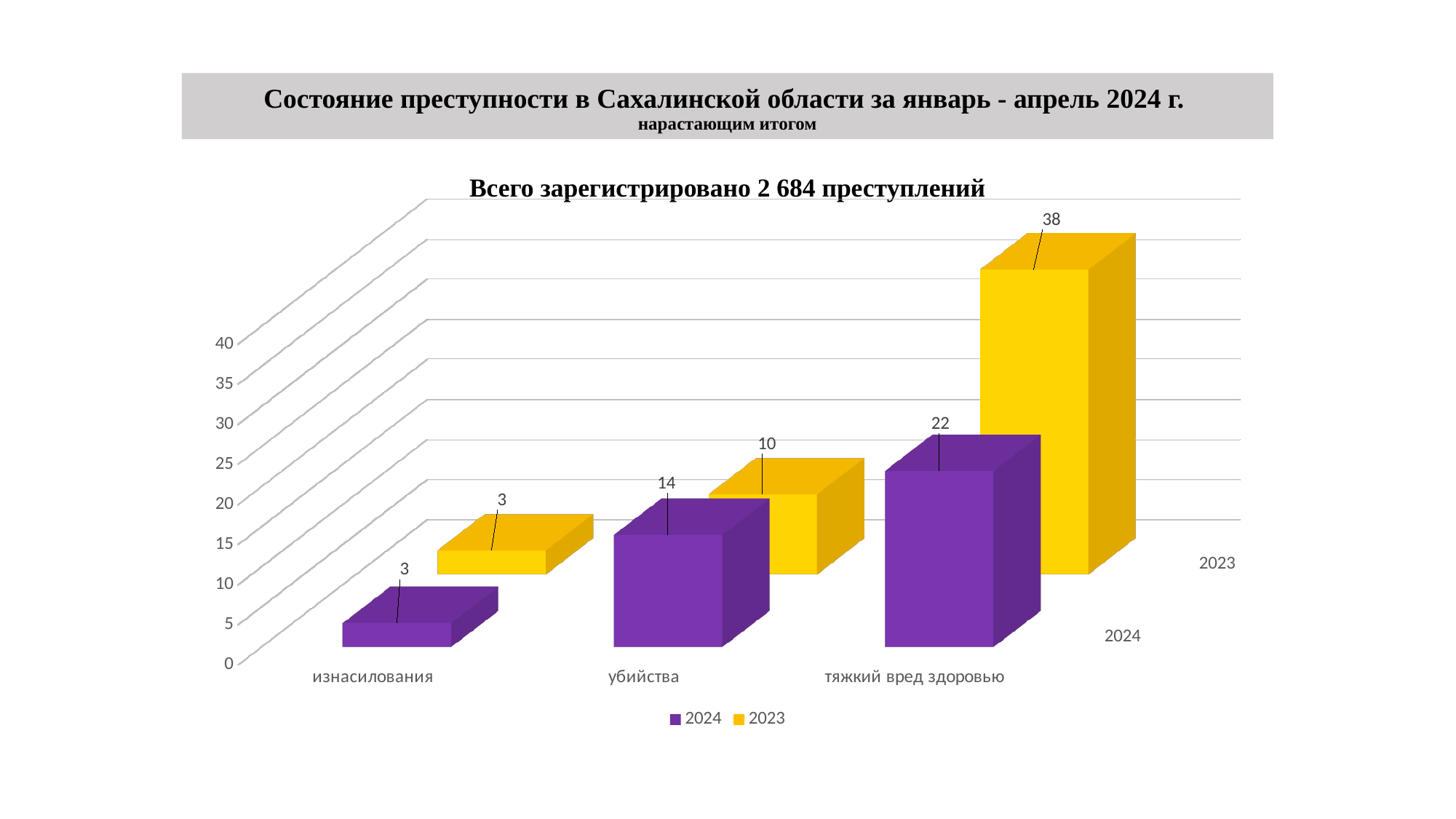
What is the value for убийства in the 2024 series? 14 What is the value for изнасилования in the 2024 series? 3 How many series does the legend list? 2 What is the difference between the 2023 and 2024 values for тяжкий вред здоровью? 16 Do the values in the 2024 series rise or fall from left to right along the x axis? rise How many categories are shown on the x axis? 3 Which is larger for убийства: the 2024 value or the 2023 value? 2024 Which category has the lowest value in the 2024 series? изнасилования What is the value for тяжкий вред здоровью in the 2023 series? 38 Which category has the highest value in the 2023 series? тяжкий вред здоровью What is the title of the chart? Всего зарегистрировано 2 684 преступлений What kind of chart is shown on the slide? bar chart